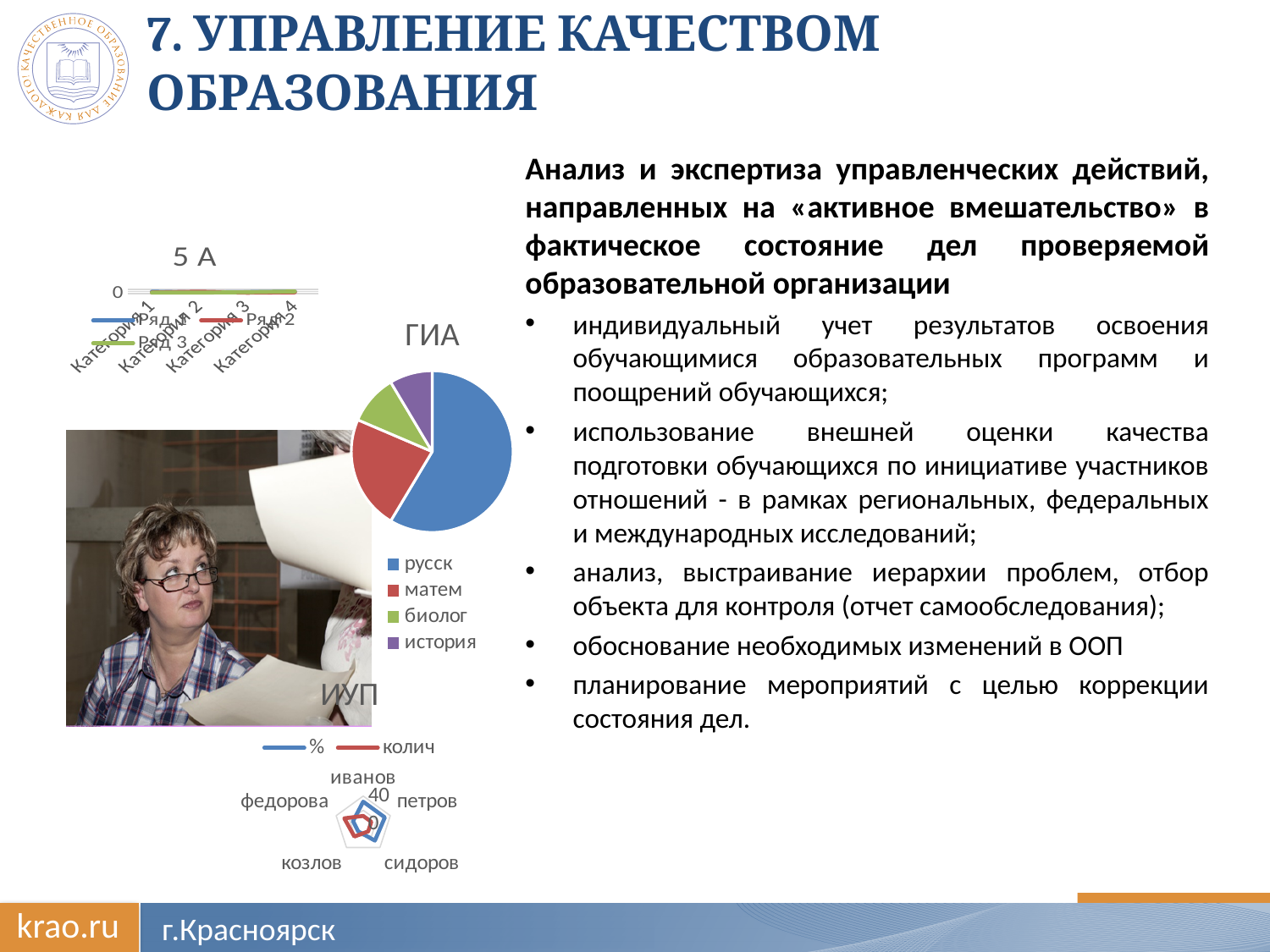
What are the series names in the legend of the "ИУП" chart? % and колич What kind of chart is the chart titled "5 А"? line chart How many series does the legend of the "ИУП" chart list? 2 What kind of chart is the chart titled "ГИА"? pie chart How many categories does the "ГИА" pie chart show? 4 How many categories are plotted on the "ИУП" radar chart? 5 In the "ГИА" pie chart, which slice is larger, русск or матем? русск How many series does the legend of the chart titled "5 А" list? 3 What kind of chart is the chart titled "ИУП"? radar chart In the "ГИА" pie chart, which category has the largest slice? русск In the "ГИА" pie chart, which slice is larger, матем or биолог? матем In the "ГИА" pie chart, which category has the smallest slice? история